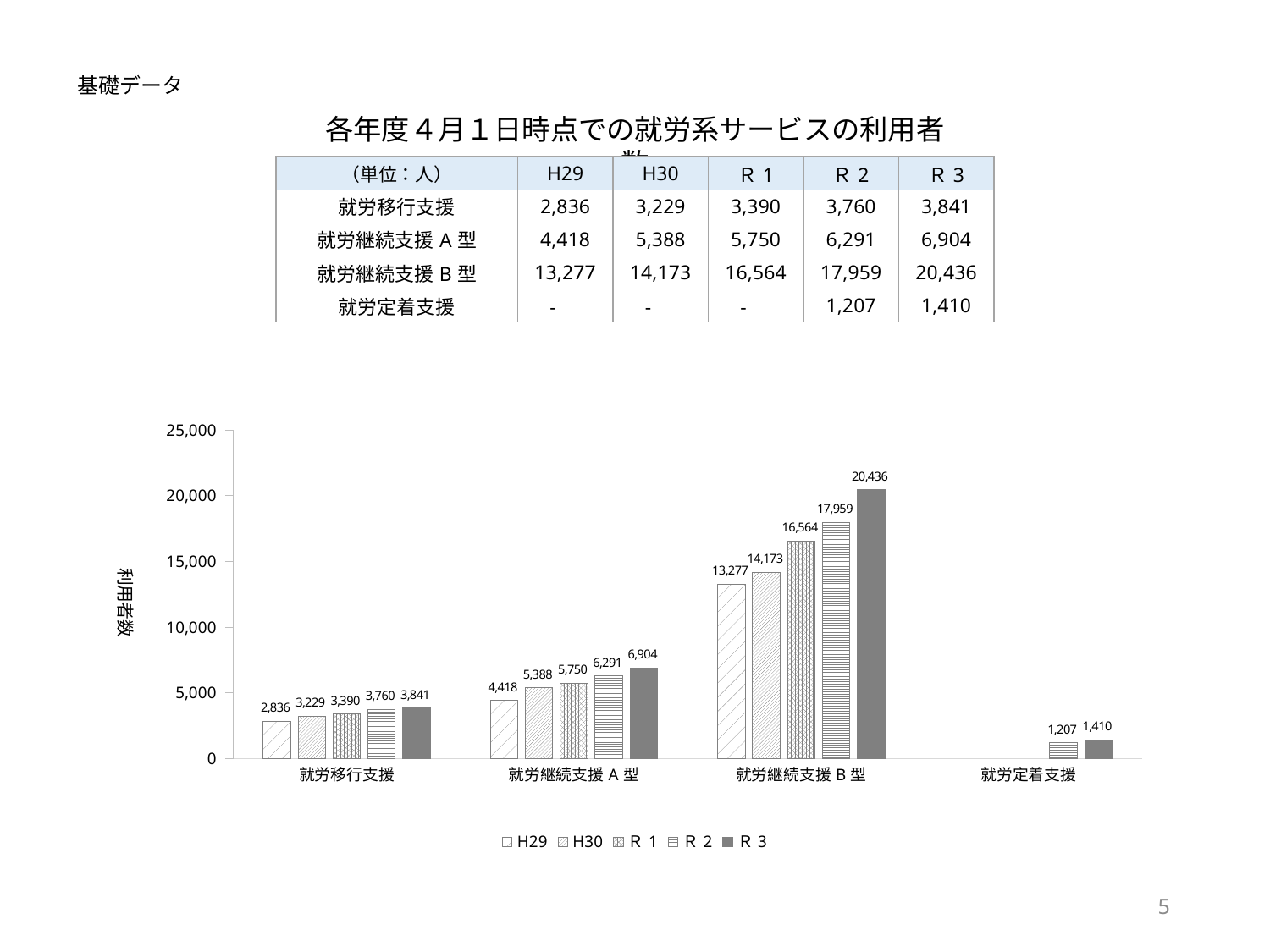
Which category has the highest value in R3? 就労継続支援Ｂ型 What is the value for 就労継続支援Ｂ型 in R3? 20,436 What is the value for 就労移行支援 in H29? 2,836 How many categories are shown on the x axis? 4 What kind of chart is shown? bar chart How many series does the legend list? 5 Which is larger: the R1 value for 就労継続支援Ａ型 or the R1 value for 就労移行支援? 就労継続支援Ａ型 What is the difference between the R3 and H29 values for 就労継続支援Ａ型? 2,486 Is the R2 value for 就労継続支援Ｂ型 greater or less than 15,000? greater Do the values for 就労継続支援Ｂ型 rise or fall from H29 to R3? rise What is the value for 就労定着支援 in R2? 1,207 Which category has the lowest value in R3? 就労定着支援